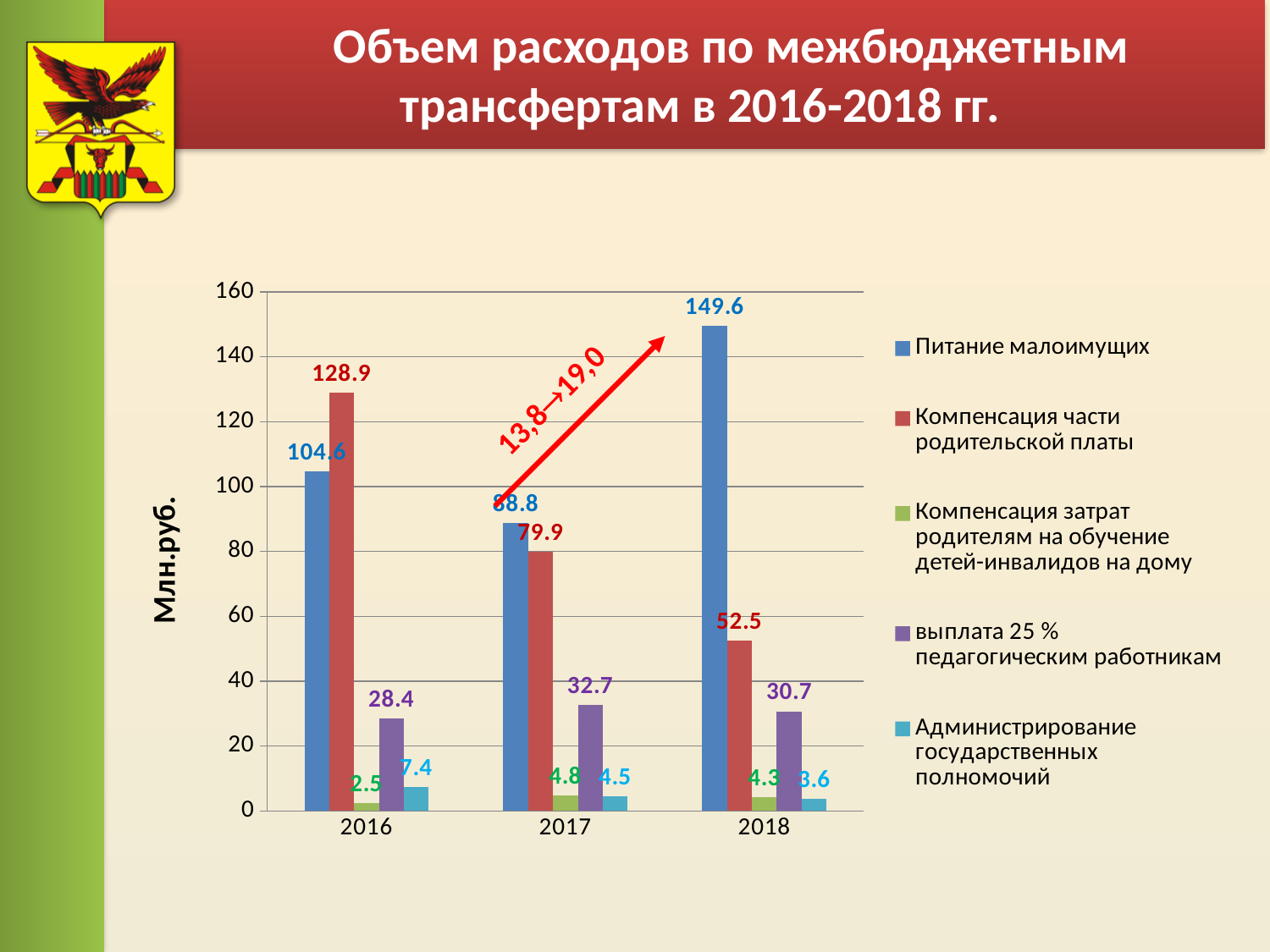
In which year is the value for Компенсация части родительской платы lowest? 2018 What is the value for Компенсация части родительской платы in 2016? 128.9 How many years are shown on the x axis? 3 What is the value for выплата 25 % педагогическим работникам in 2017? 32.7 How many series does the legend list? 5 In which year is the value for Питание малоимущих highest? 2018 What is the value for Питание малоимущих in 2018? 149.6 Does the value for Компенсация части родительской платы rise or fall from 2016 to 2018? fall What type of chart is shown on the slide? bar chart What is the difference between Питание малоимущих in 2018 and in 2016? 45.0 Which is larger in 2016: Питание малоимущих or Компенсация части родительской платы? Компенсация части родительской платы What is the value for Администрирование государственных полномочий in 2018? 3.6